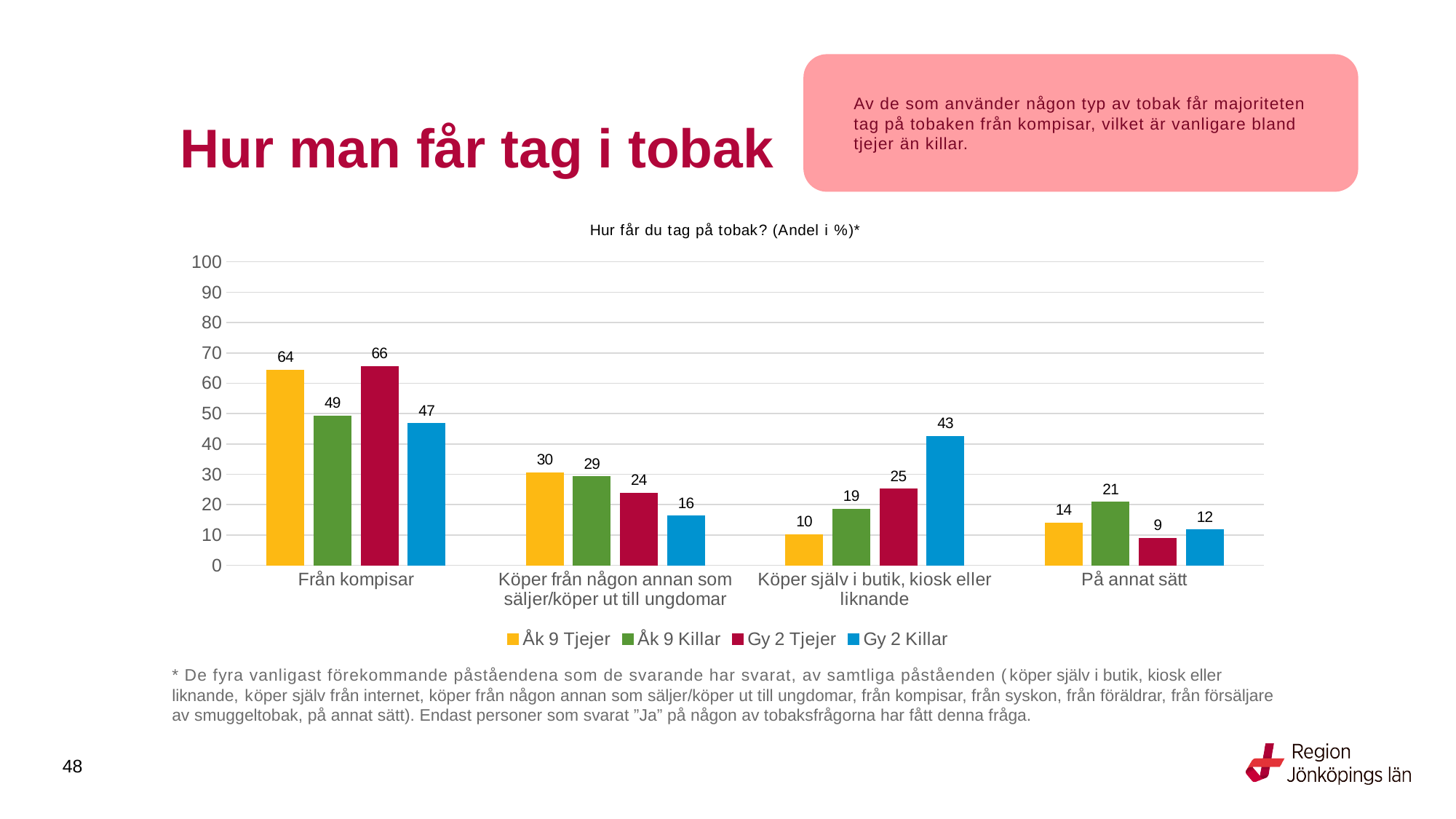
What is the value for Gy 2 Tjejer in the 'Från kompisar' category? 66 What kind of chart is shown on the slide? Bar chart Which series has the highest value in the 'Från kompisar' category? Gy 2 Tjejer How many series does the legend list? 4 What is the value for Gy 2 Killar in the 'Köper själv i butik, kiosk eller liknande' category? 43 What is the difference between Åk 9 Tjejer and Gy 2 Killar in the 'Köper från någon annan som säljer/köper ut till ungdomar' category? 14 Which is larger in the 'Köper själv i butik, kiosk eller liknande' category: Åk 9 Killar or Gy 2 Tjejer? Gy 2 Tjejer What is the title of the chart? Hur får du tag på tobak? (Andel i %)* Which series has the lowest value in the 'På annat sätt' category? Gy 2 Tjejer Is the value for Åk 9 Tjejer in 'Från kompisar' greater or less than 60? greater What is the value for Åk 9 Killar in the 'På annat sätt' category? 21 How many categories are shown on the x axis? 4